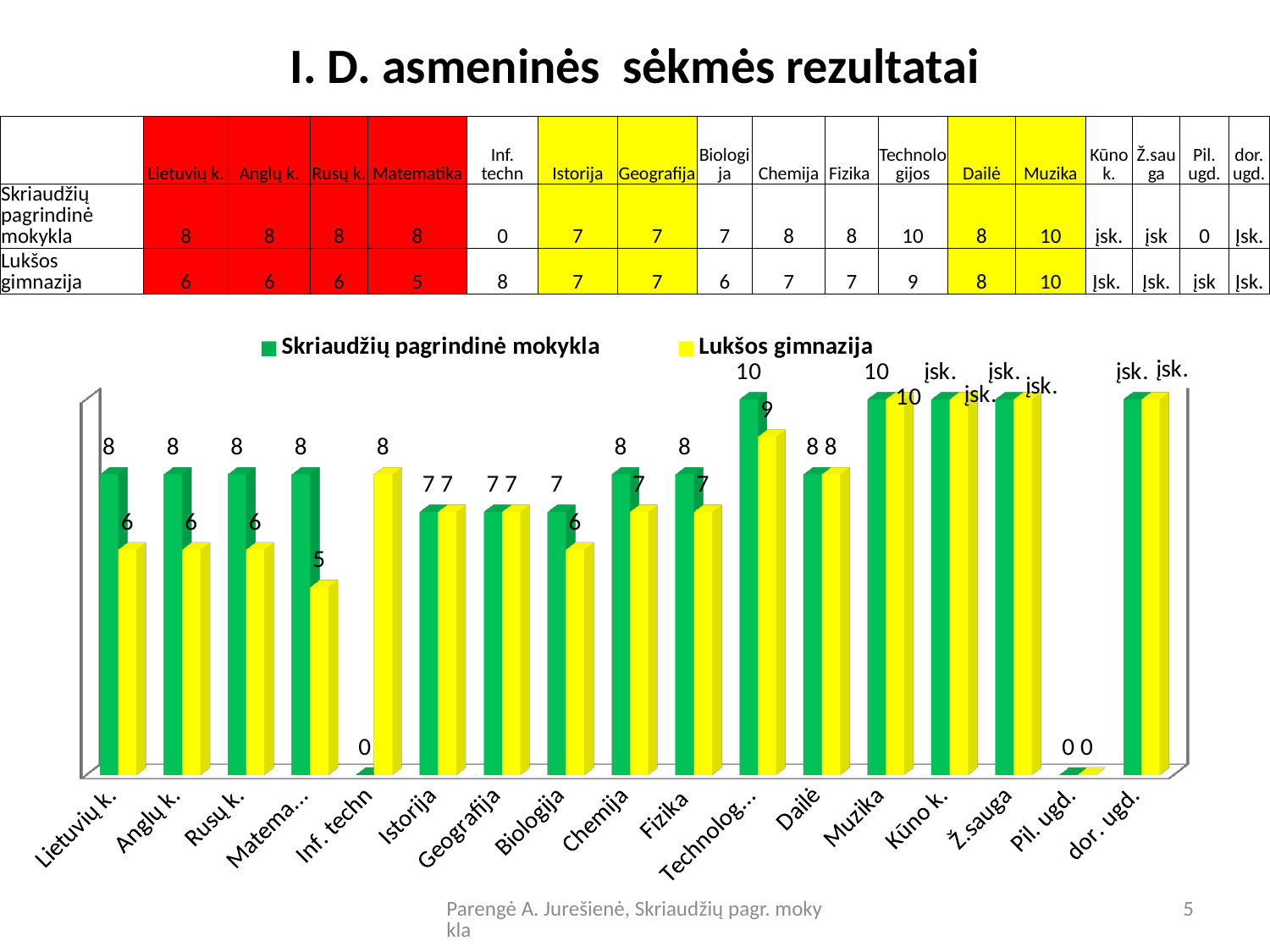
What is the difference between Skriaudžių pagrindinė mokykla and Lukšos gimnazija in Anglų k.? 2 Which colour represents Lukšos gimnazija in the chart? yellow What is the value for Lukšos gimnazija in Inf. techn? 8 Which series has the larger value in Biologija, Skriaudžių pagrindinė mokykla or Lukšos gimnazija? Skriaudžių pagrindinė mokykla What is the value for Lukšos gimnazija in Matematika? 5 Which series has the larger value in Inf. techn, Skriaudžių pagrindinė mokykla or Lukšos gimnazija? Lukšos gimnazija What is the value for Lukšos gimnazija in Technologijos? 9 What kind of chart is shown on the slide? bar chart What is the value for Skriaudžių pagrindinė mokykla in Technologijos? 10 How many series does the chart legend list? 2 What is the value for Skriaudžių pagrindinė mokykla in Lietuvių k.? 8 What is the value for both series in Muzika? 10